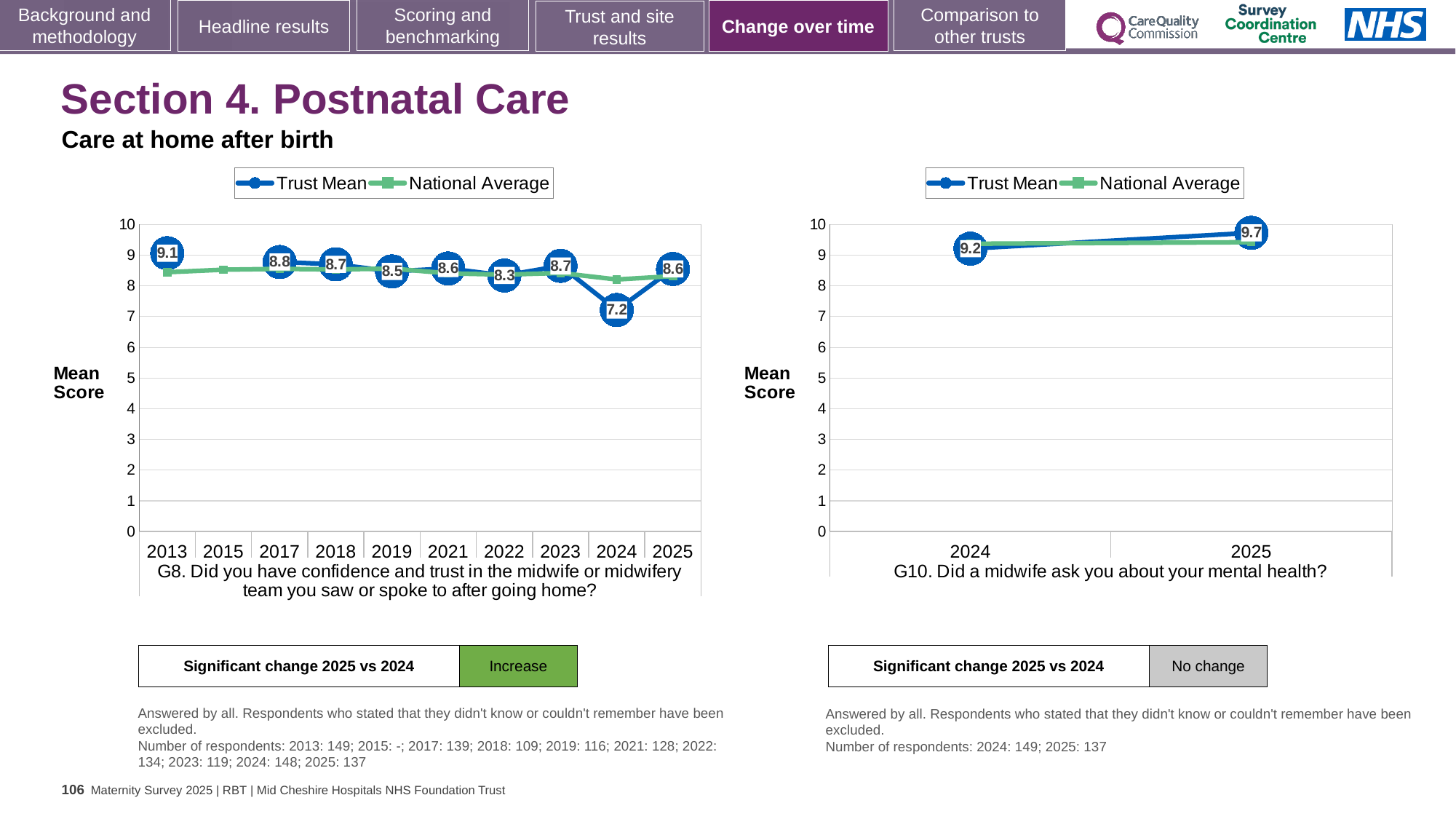
In the G8 chart (left), how many years are shown on the x axis? 10 In the G8 chart (left), which year has the higher Trust Mean score, 2022 or 2023? 2023 How many series does the legend of the G8 chart (left) list? 2 In the G8 chart (left), which year has the highest Trust Mean score? 2013 In the G10 chart (right), what is the Trust Mean score for 2025? 9.7 In the G8 chart (left), is the National Average for 2013 greater or less than 8? greater In the G10 chart (right), does the Trust Mean rise or fall from 2024 to 2025? rises In the G8 chart (left), by how much did the Trust Mean score change from 2024 to 2025? 1.4 In the G8 chart (left), what is the Trust Mean score for 2024? 7.2 In the G8 chart (left), what is the Trust Mean score for 2013? 9.1 In the G8 chart (left), which year has the lowest Trust Mean score? 2024 In the G10 chart (right), what is the difference between the Trust Mean scores for 2025 and 2024? 0.5